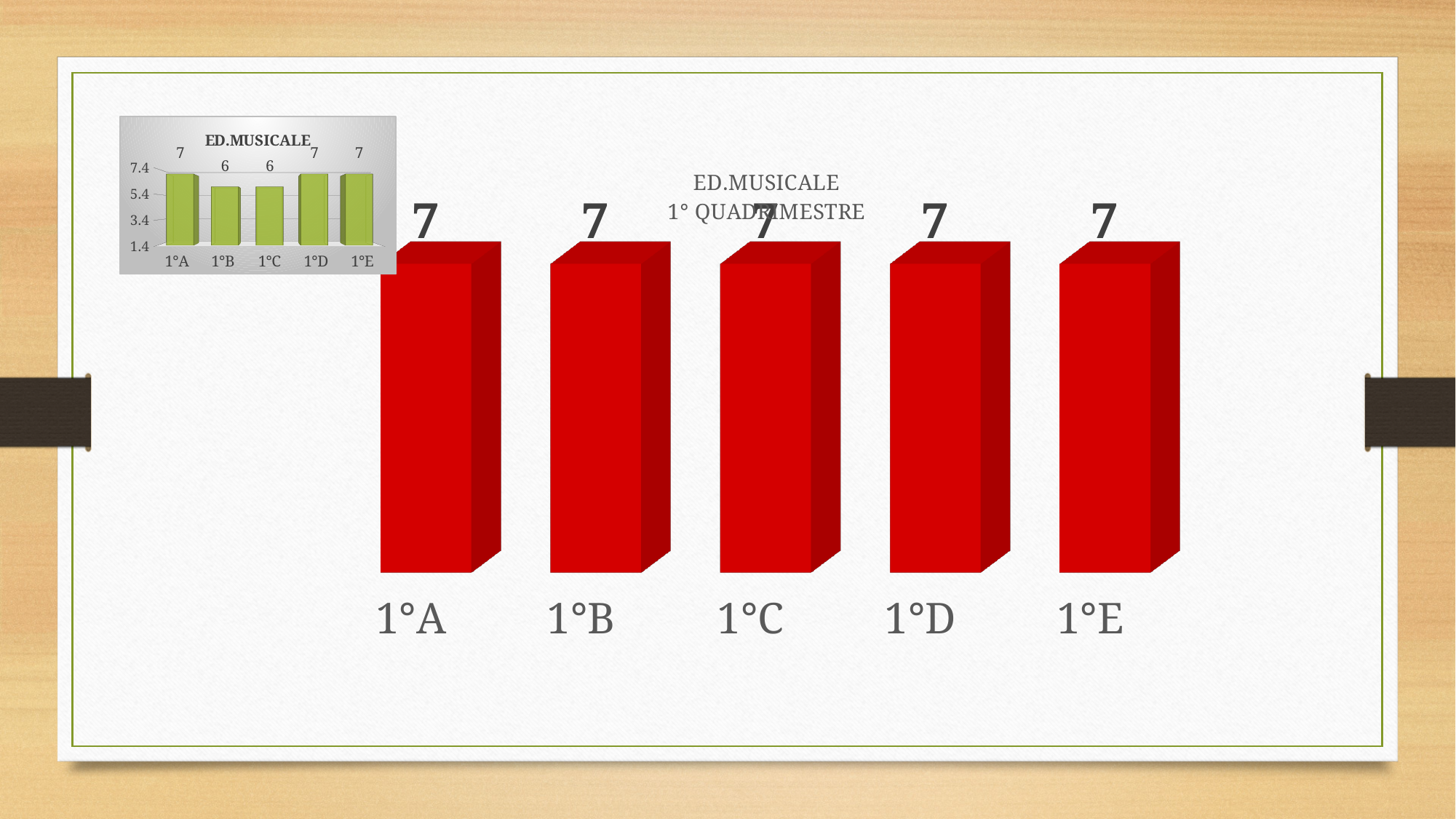
In the small chart at the top left titled "ED.MUSICALE", which category has the lowest value, 1°A or 1°C? 1°C In the small chart at the top left titled "ED.MUSICALE", what is the value for 1°D? 7 In the small chart at the top left titled "ED.MUSICALE", how many categories are shown? 5 In the large red chart titled "ED.MUSICALE 1° QUADRIMESTRE", how many categories are shown? 5 In the large red chart titled "ED.MUSICALE 1° QUADRIMESTRE", do the values rise, fall or stay the same from 1°A to 1°E? stay the same In the large red chart titled "ED.MUSICALE 1° QUADRIMESTRE", what is the difference between the values for 1°A and 1°E? 0 What kind of chart is the large red chart titled "ED.MUSICALE 1° QUADRIMESTRE"? bar chart What is the title of the large red chart on the slide? ED.MUSICALE 1° QUADRIMESTRE In the large red chart titled "ED.MUSICALE 1° QUADRIMESTRE", what is the value for 1°C? 7 In the small chart at the top left titled "ED.MUSICALE", what is the difference between the values for 1°A and 1°B? 1 In the small chart at the top left titled "ED.MUSICALE", what is the value for 1°B? 6 In the small chart at the top left titled "ED.MUSICALE", is the value for 1°C greater or less than 5.4? greater